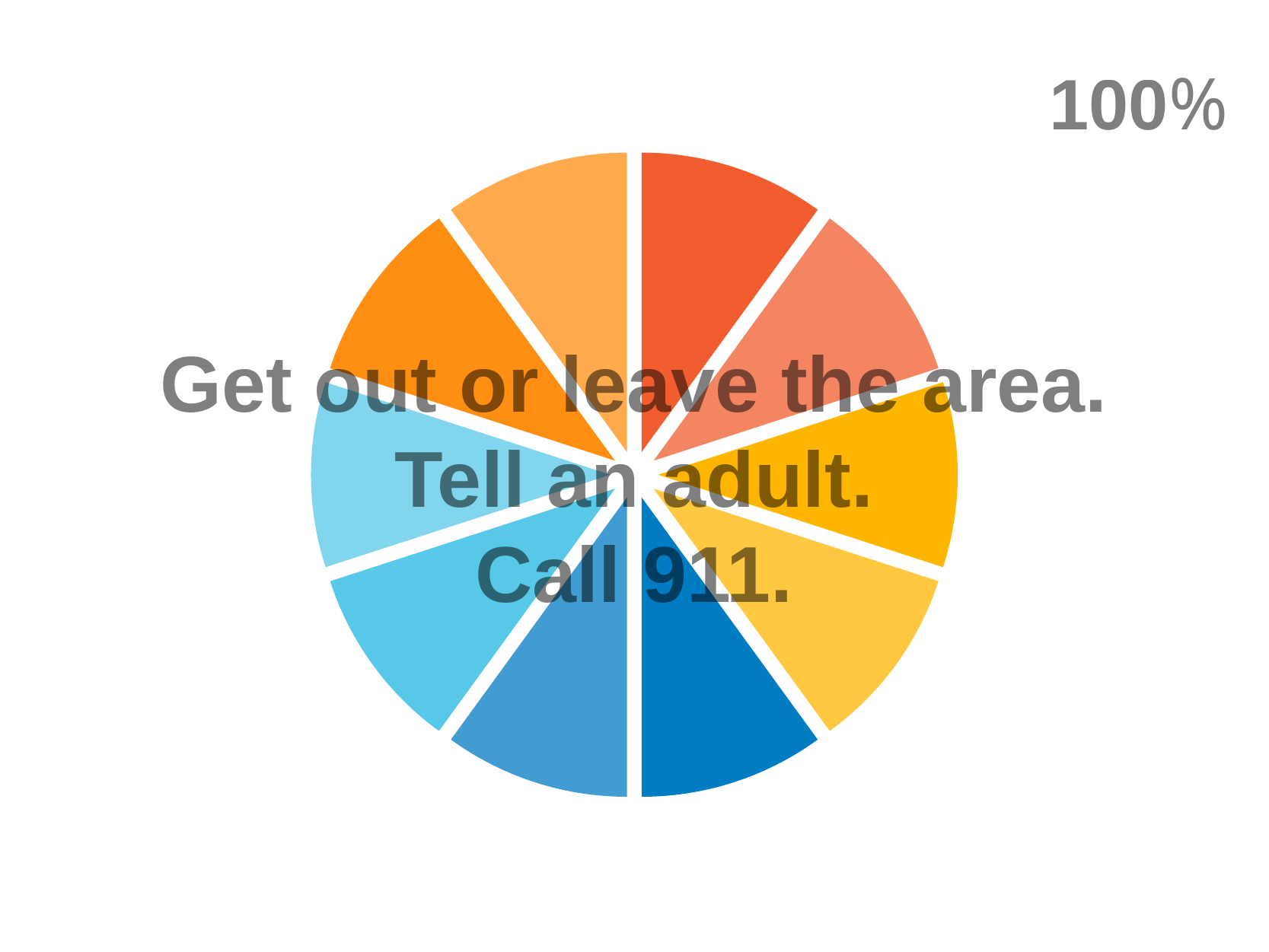
What kind of chart is shown on the slide? pie chart How many slices does the pie chart have? 10 Do the slices of the pie chart appear to be equal in size? yes What percentage figure is printed in the top-right corner of the slide? 100% Does the pie chart have a legend? no What text is written over the pie chart? Get out or leave the area. Tell an adult. Call 911.